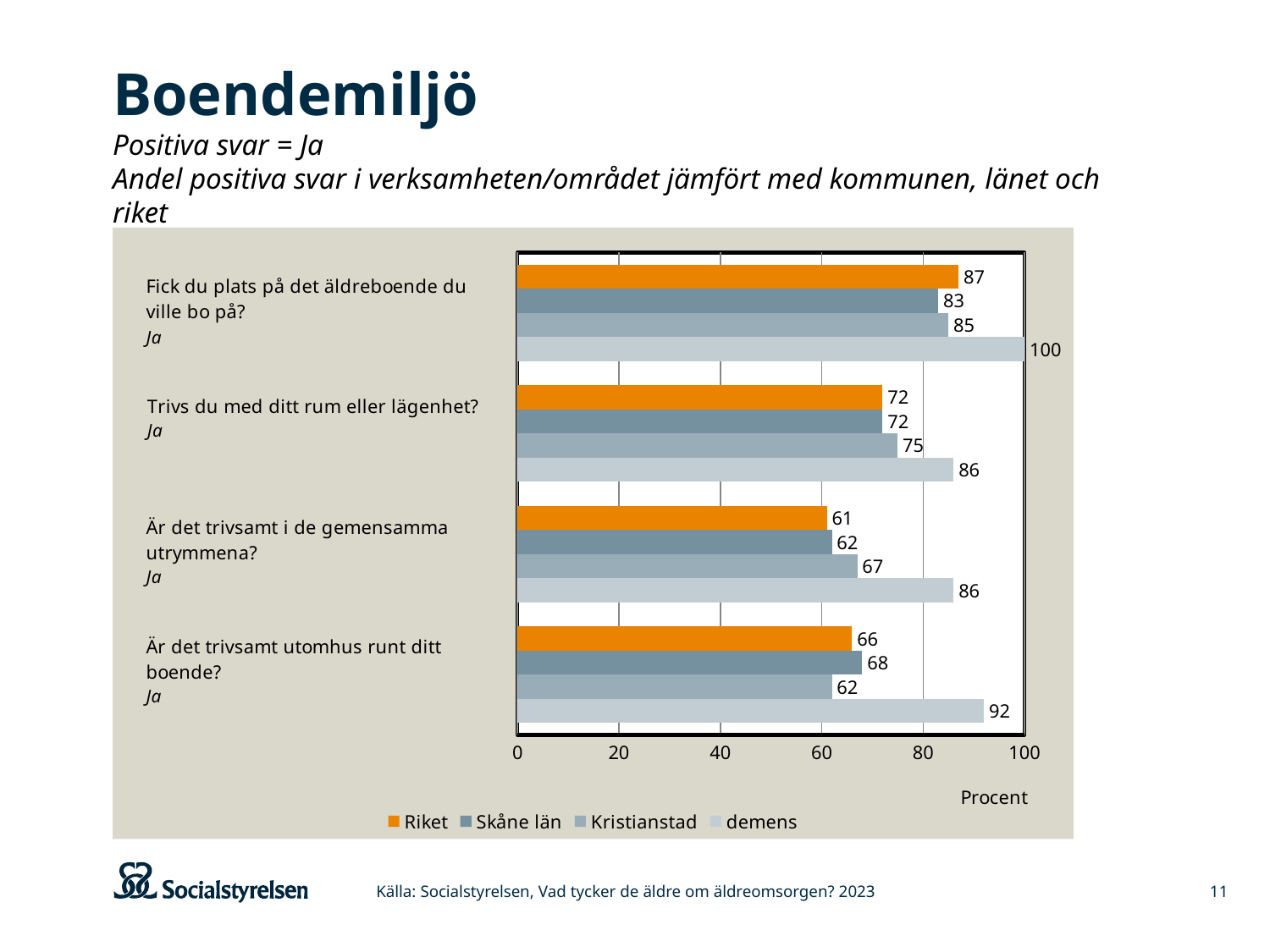
For 'Är det trivsamt utomhus runt ditt boende?', which is larger: the value for 'Skåne län' or the value for 'Kristianstad'? Skåne län What is the value for 'Skåne län' for 'Är det trivsamt utomhus runt ditt boende?'? 68 What is the value for 'Riket' for 'Trivs du med ditt rum eller lägenhet?'? 72 What kind of chart is shown on the slide? Bar chart Which question has the highest value for the 'demens' series? Fick du plats på det äldreboende du ville bo på? What is the label of the horizontal axis? Procent What is the difference between the 'demens' value and the 'Riket' value for 'Är det trivsamt i de gemensamma utrymmena?'? 25 What is the value for 'demens' for the question 'Fick du plats på det äldreboende du ville bo på?'? 100 What is the value for 'Kristianstad' for 'Är det trivsamt i de gemensamma utrymmena?'? 67 Which question has the lowest value for the 'Riket' series? Är det trivsamt i de gemensamma utrymmena? How many series does the legend list? 4 How many questions (categories) are shown on the chart? 4